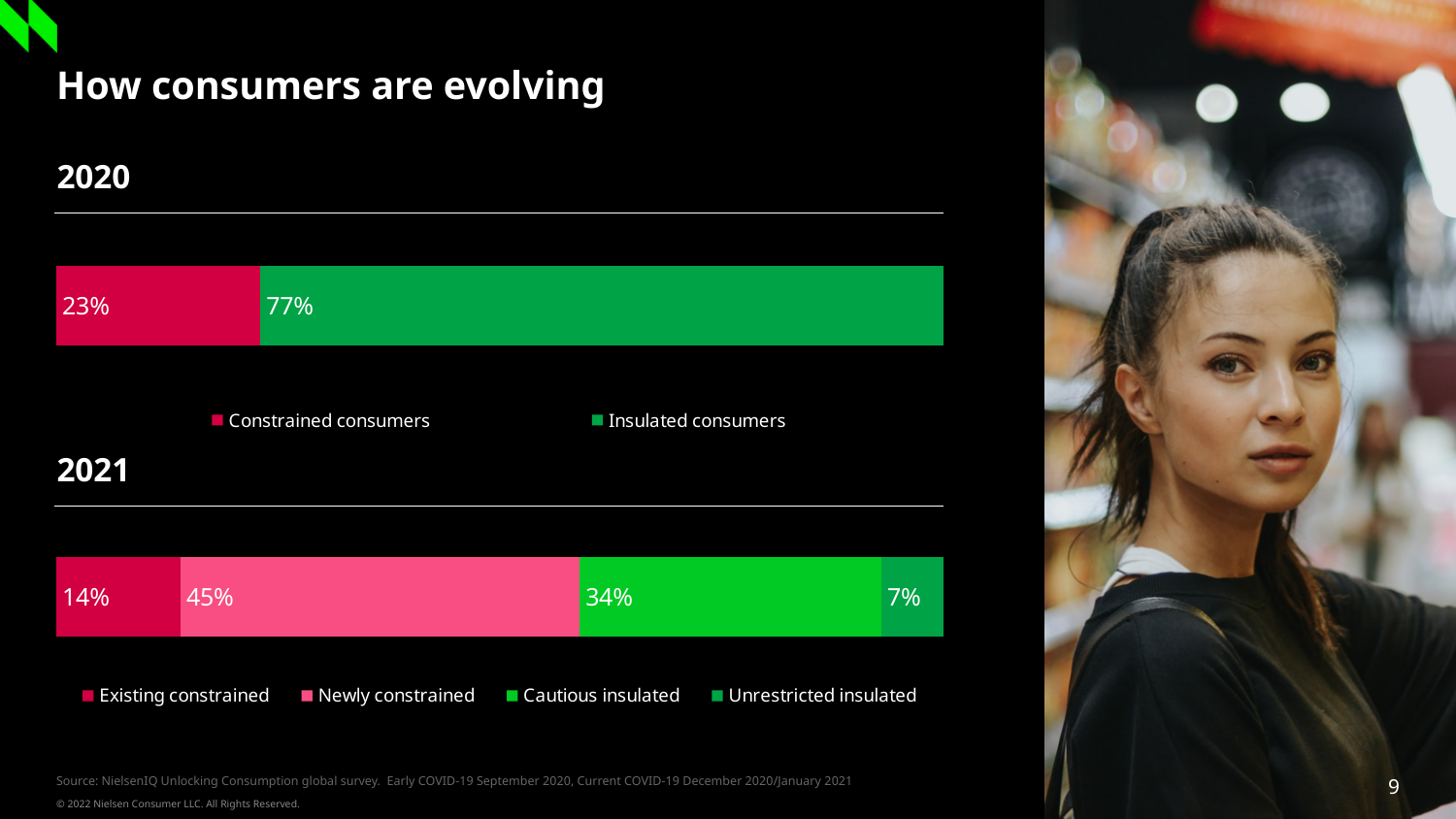
In the 2021 chart, what is the difference between Newly constrained and Cautious insulated? 11% In the 2020 chart, what percentage is shown for Insulated consumers? 77% In the 2021 chart, what percentage is shown for Unrestricted insulated? 7% In the 2021 chart, which is larger: Existing constrained or Cautious insulated? Cautious insulated In the 2021 chart, what percentage is shown for Newly constrained? 45% In the 2020 chart, what percentage is shown for Constrained consumers? 23% How many series does the legend of the 2021 chart list? 4 In the 2020 chart, what is the difference between Insulated consumers and Constrained consumers? 54% What kind of chart is the 2021 chart? Stacked bar chart How many series does the legend of the 2020 chart list? 2 In the 2021 chart, which segment has the smallest share? Unrestricted insulated In the 2021 chart, which segment has the largest share? Newly constrained